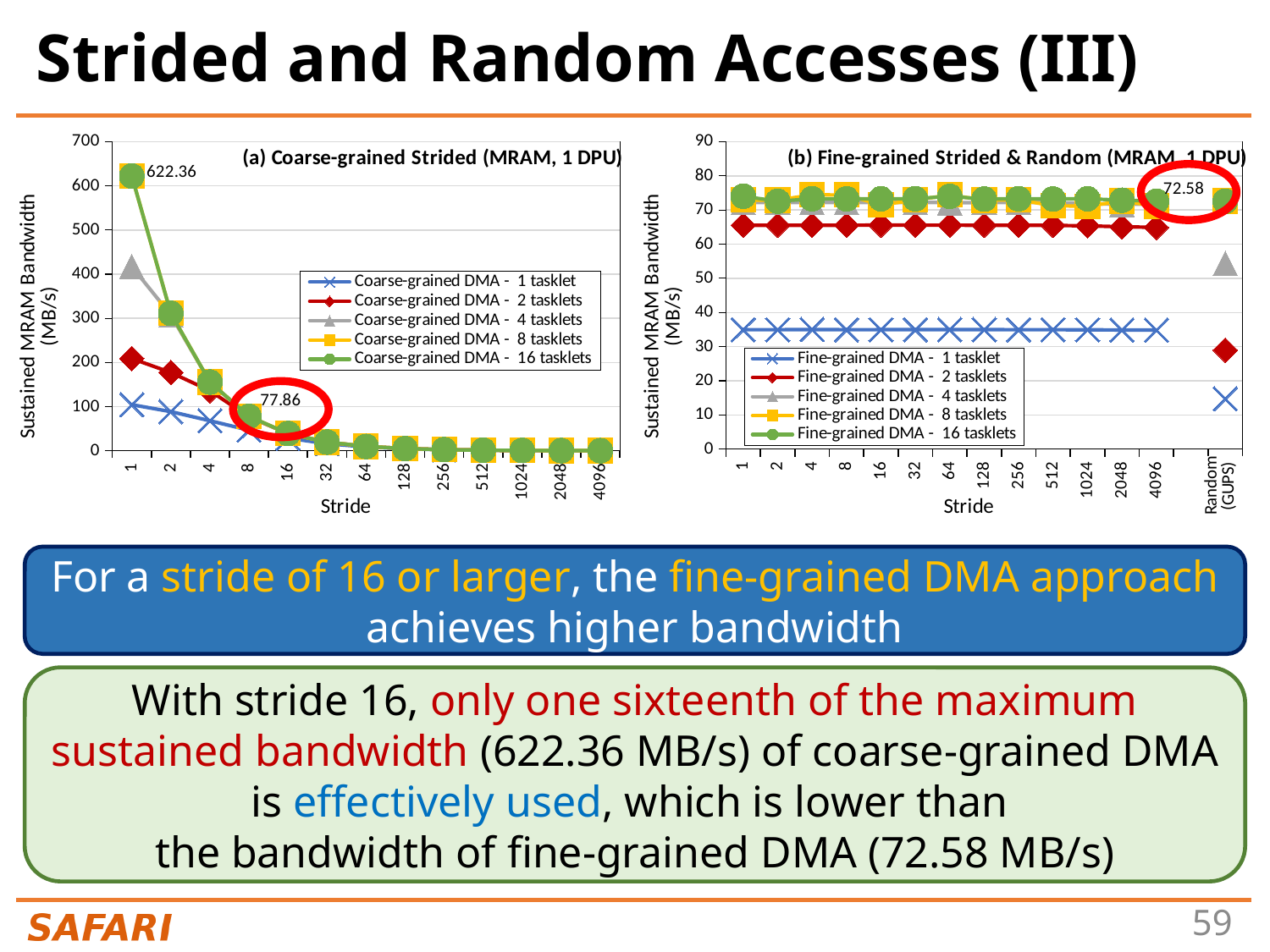
In chart (a) Coarse-grained Strided (MRAM, 1 DPU), do the bandwidth values rise or fall as the stride increases? Fall In chart (a) Coarse-grained Strided (MRAM, 1 DPU), what is the labelled bandwidth value at stride 16? 77.86 In chart (a) Coarse-grained Strided (MRAM, 1 DPU), what is the difference between the labelled value at stride 1 and the labelled value at stride 16? 544.5 What kind of chart is chart (a) Coarse-grained Strided (MRAM, 1 DPU)? Line chart In chart (a) Coarse-grained Strided (MRAM, 1 DPU), how many series does the legend list? 5 In chart (b) Fine-grained Strided & Random (MRAM, 1 DPU), at the Random (GUPS) category, which is larger: Fine-grained DMA - 4 tasklets or Fine-grained DMA - 1 tasklet? Fine-grained DMA - 4 tasklets In chart (b) Fine-grained Strided & Random (MRAM, 1 DPU), is the value for Fine-grained DMA - 1 tasklet at stride 1 greater or less than 40? less In chart (b) Fine-grained Strided & Random (MRAM, 1 DPU), how many categories are shown on the x axis? 14 In chart (a) Coarse-grained Strided (MRAM, 1 DPU), what is the labelled bandwidth value at stride 1? 622.36 In chart (a) Coarse-grained Strided (MRAM, 1 DPU), how many stride values are shown on the x axis? 13 In chart (b) Fine-grained Strided & Random (MRAM, 1 DPU), how many series does the legend list? 5 In chart (b) Fine-grained Strided & Random (MRAM, 1 DPU), what is the labelled bandwidth value for the Random (GUPS) category? 72.58